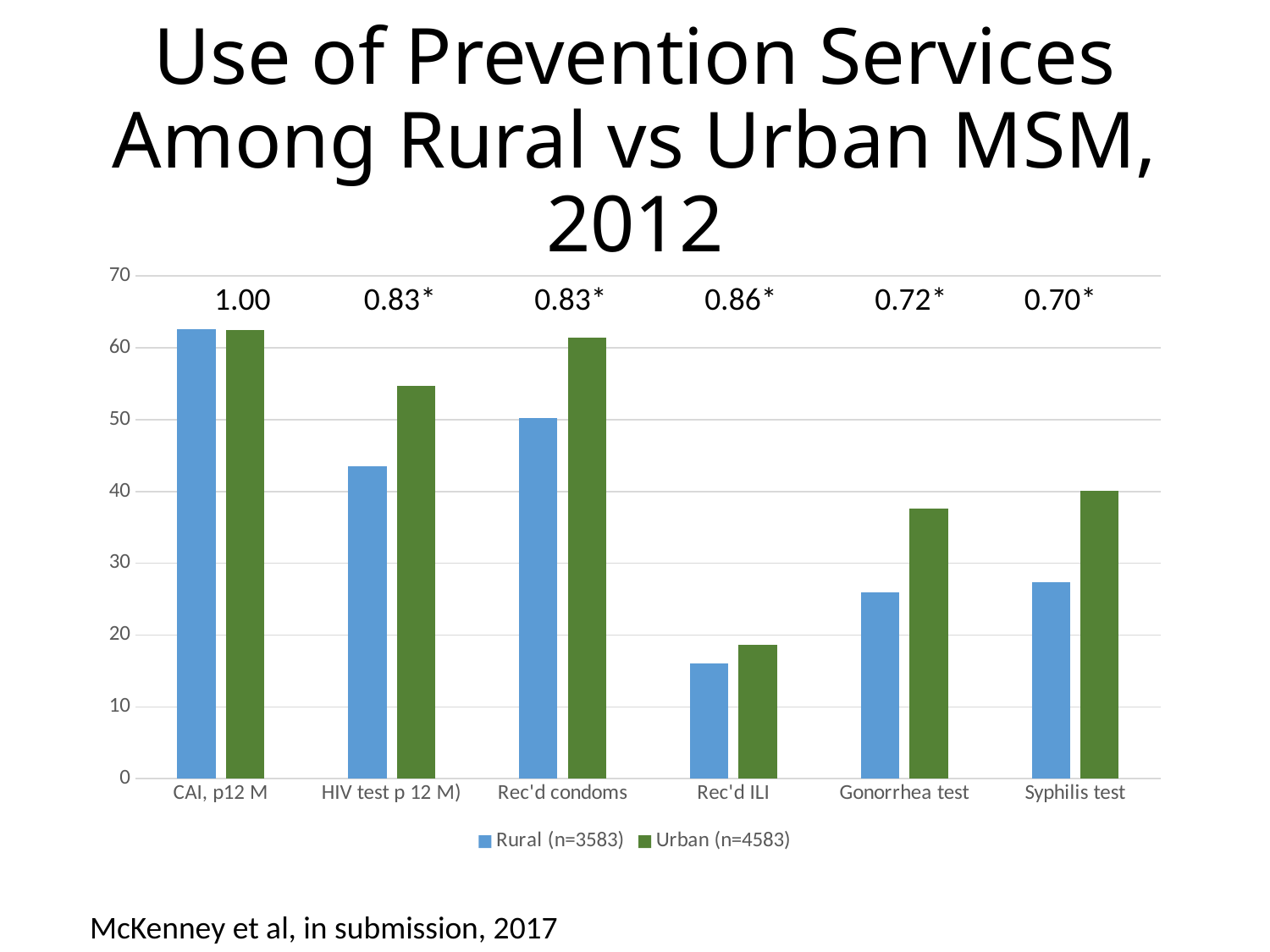
What ratio label is printed above the Syphilis test bars? 0.70* What kind of chart is shown on the slide? bar chart Which category has the lowest value for the Rural (n=3583) series? Rec'd ILI For Syphilis test, which series has the larger value, Rural (n=3583) or Urban (n=4583)? Urban (n=4583) Which category has the highest value for the Rural (n=3583) series? CAI, p12 M Is the Rural (n=3583) value for Rec'd ILI greater or less than 20? less How many series does the legend list? 2 Is the Urban (n=4583) value for Gonorrhea test greater or less than 30? greater For HIV test p 12 M), which series has the larger value, Rural (n=3583) or Urban (n=4583)? Urban (n=4583) Which category has the lowest value for the Urban (n=4583) series? Rec'd ILI Is the Rural (n=3583) value for Rec'd condoms greater or less than 40? greater How many categories are shown on the x axis? 6